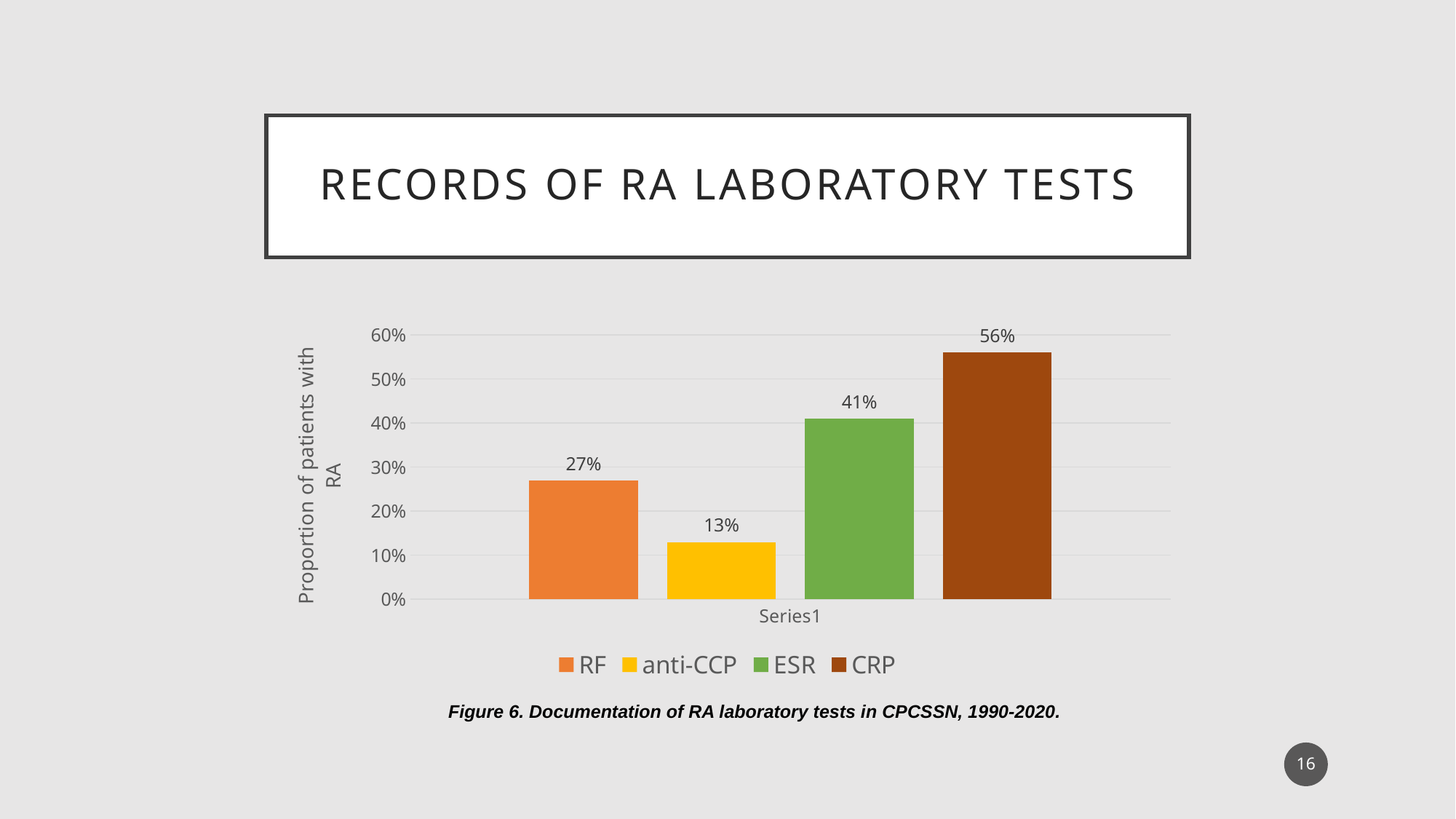
What is the value for anti-CCP? 13% What is the value for RF? 27% What is the label of the vertical axis? Proportion of patients with RA What is the difference between the values for CRP and ESR? 15% How many series does the legend list? 4 Which is larger, the value for ESR or the value for RF? ESR Which laboratory test has the lowest proportion of patients with RA? anti-CCP What is the value for CRP? 56% What is the difference between the values for RF and anti-CCP? 14% Which laboratory test has the highest proportion of patients with RA? CRP What is the value for ESR? 41% What kind of chart is shown on the slide? Bar chart